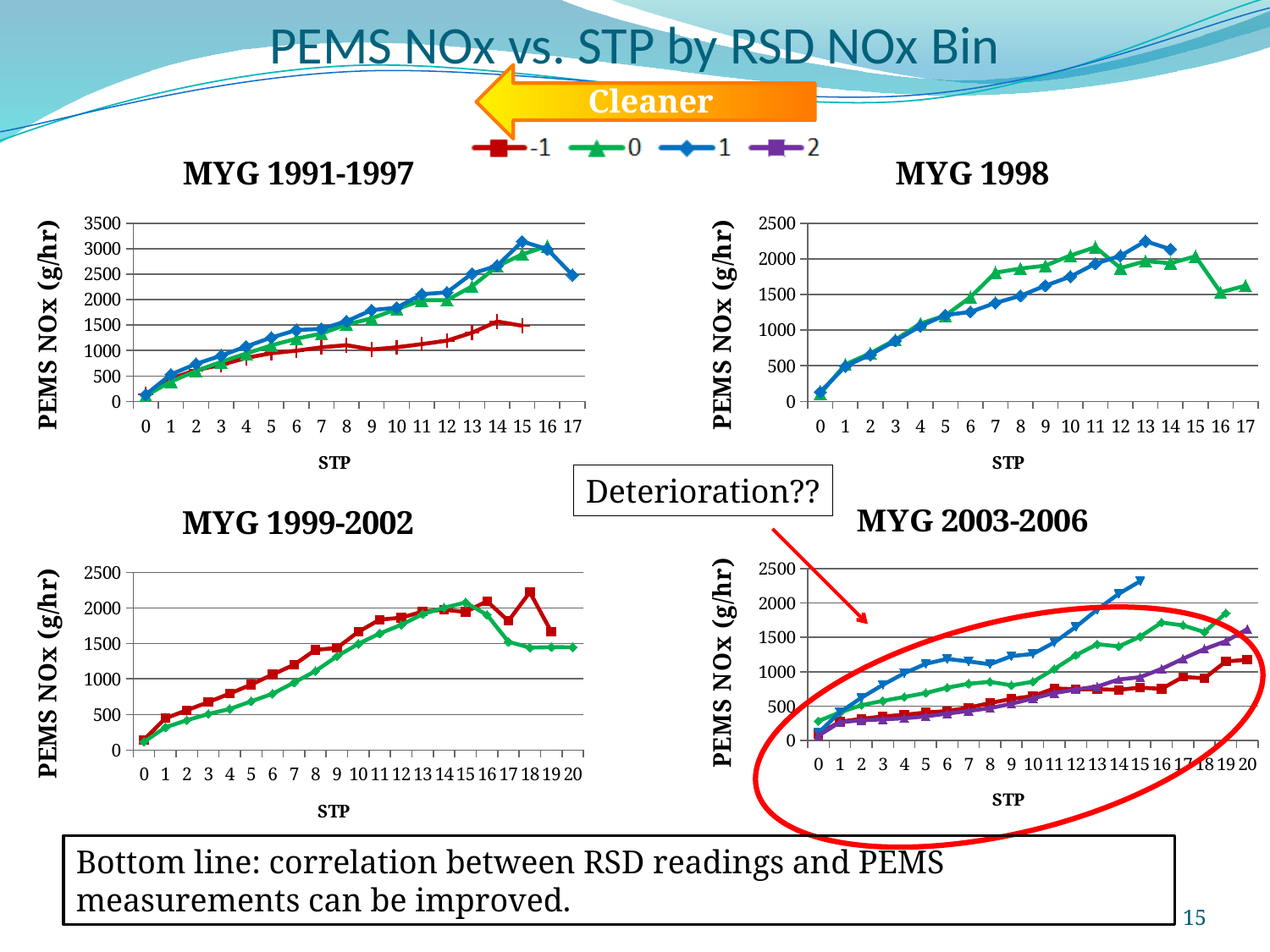
In the MYG 1991-1997 chart, at STP 14, which is larger: series 1 or series -1? series 1 In the MYG 2003-2006 chart, which series has the highest value at STP 15? 1 In the MYG 1998 chart, how many series are plotted? 2 In the MYG 2003-2006 chart, is the value for series 0 at STP 0 greater or less than 500? less What is the y-axis label on the MYG 2003-2006 chart? PEMS NOx (g/hr) In the MYG 1999-2002 chart, do the values for series 0 rise or fall from STP 0 to STP 15? rise In the MYG 1998 chart, is the value for series 1 at STP 13 greater or less than 2000? greater In the MYG 1991-1997 chart, is the value for series 1 at STP 10 greater or less than 1500? greater What kind of chart is the MYG 1991-1997 chart? line chart How many series does the shared legend at the top of the slide list? 4 What is the highest tick value on the y axis of the MYG 1991-1997 chart? 3500